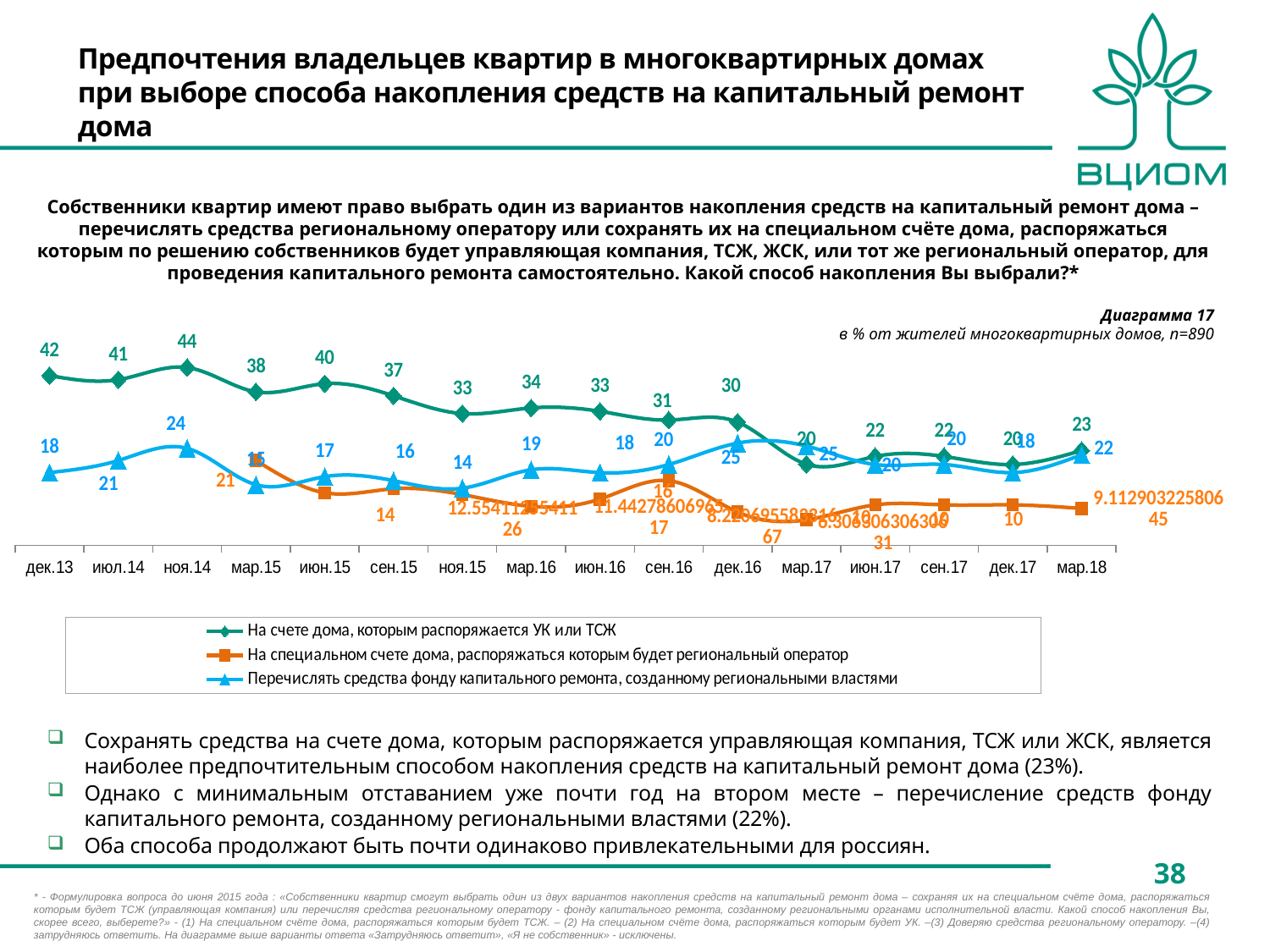
What kind of chart is shown on the slide? line chart What is the value for 'Перечислять средства фонду капитального ремонта, созданному региональными властями' in мар.18? 22 In which period does 'Перечислять средства фонду капитального ремонта, созданному региональными властями' reach its lowest value? ноя.15 What is the value for 'На счете дома, которым распоряжается УК или ТСЖ' in мар.18? 23 Does the value for 'На счете дома, которым распоряжается УК или ТСЖ' generally rise or fall from дек.13 to мар.18? fall Is the value for 'На специальном счете дома, распоряжаться которым будет региональный оператор' in мар.18 greater or less than 10? less Which is larger in сен.16: 'На счете дома, которым распоряжается УК или ТСЖ' or 'Перечислять средства фонду капитального ремонта, созданному региональными властями'? На счете дома, которым распоряжается УК или ТСЖ What is the value for 'На счете дома, которым распоряжается УК или ТСЖ' in дек.13? 42 How many time points are shown on the x axis? 16 In which period does 'На счете дома, которым распоряжается УК или ТСЖ' reach its highest value? ноя.14 What is the difference between 'На счете дома, которым распоряжается УК или ТСЖ' and 'Перечислять средства фонду капитального ремонта, созданному региональными властями' in дек.13? 24 How many series does the legend list? 3